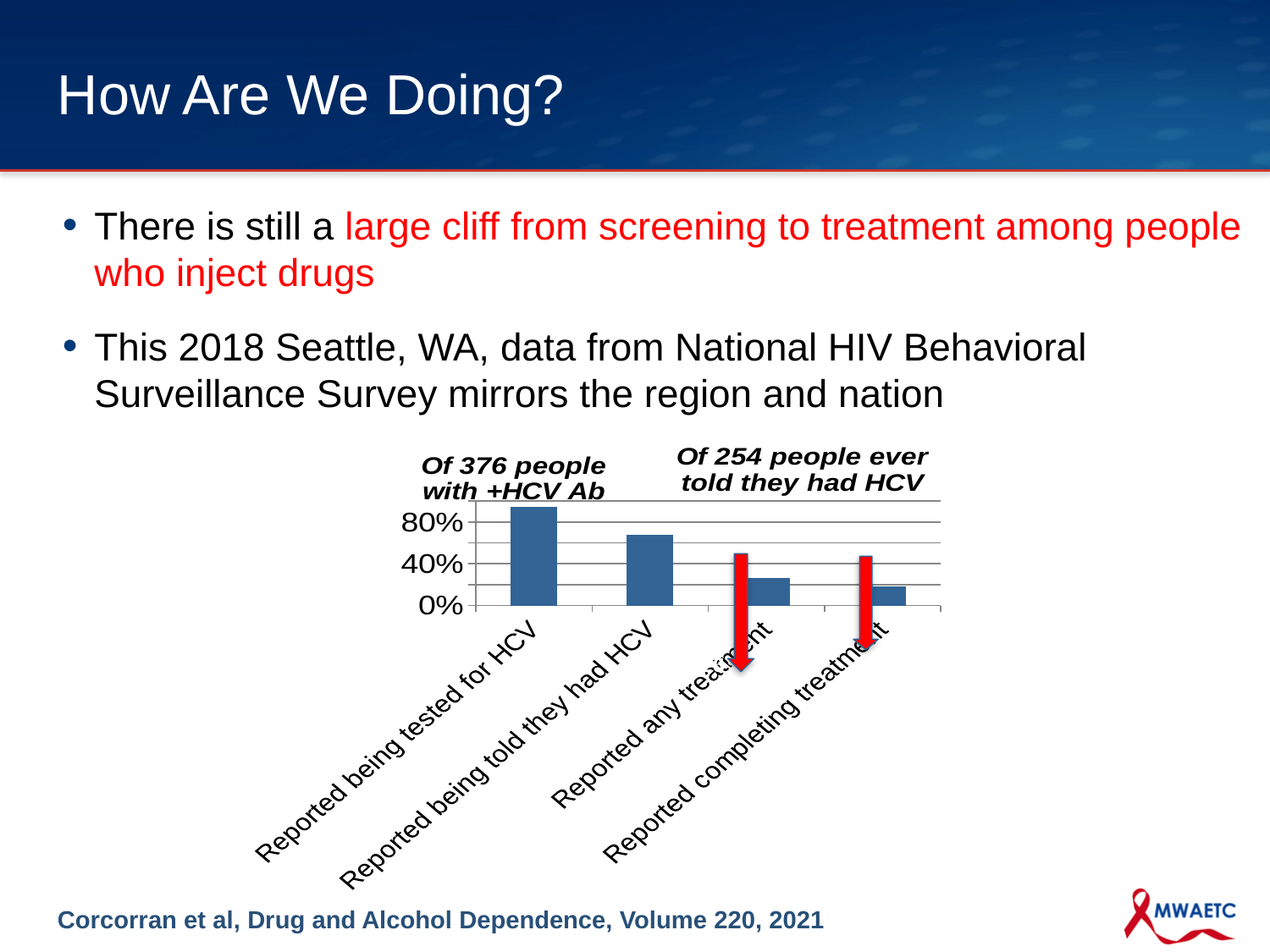
According to the annotation above the first two bars, how many people with +HCV Ab are they based on? 376 Which category has the lowest value on the chart? Reported completing treatment Is the value for 'Reported being told they had HCV' greater or less than 40%? greater Which category has the highest value on the chart? Reported being tested for HCV Is the value for 'Reported completing treatment' greater or less than 40%? less Is the value for 'Reported any treatment' greater or less than 40%? less Which is larger: the value for 'Reported being told they had HCV' or the value for 'Reported any treatment'? Reported being told they had HCV What kind of chart is shown on the slide? bar chart How many categories are plotted on the chart? 4 According to the annotation above the last two bars, how many people ever told they had HCV are they based on? 254 Do the bar values rise or fall moving from left to right along the x axis? fall